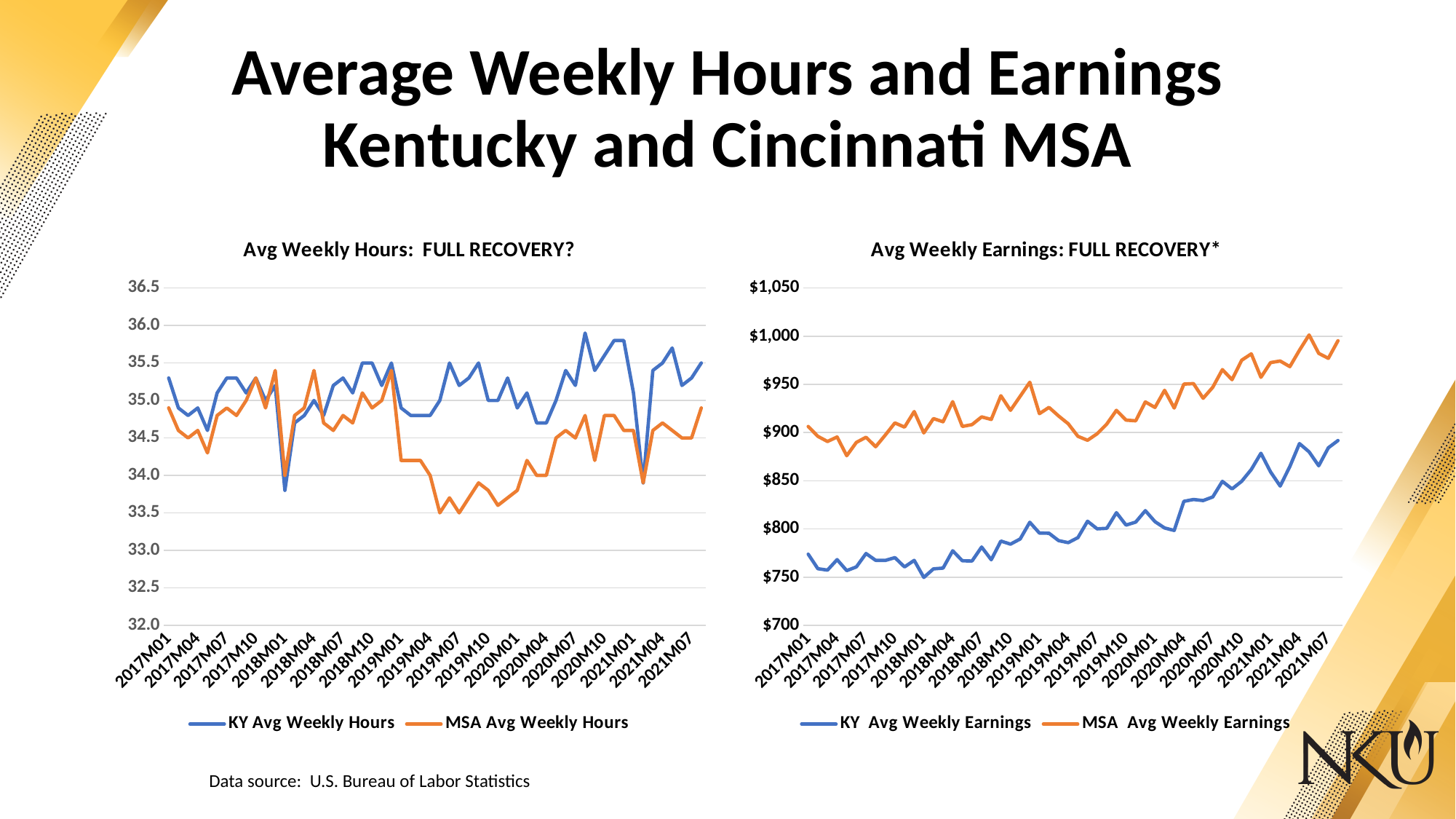
In the right chart, "Avg Weekly Earnings: FULL RECOVERY*", does MSA Avg Weekly Earnings generally rise or fall from 2019M07 to 2021M07? rise In the right chart, "Avg Weekly Earnings: FULL RECOVERY*", which series is higher at 2019M01, KY Avg Weekly Earnings or MSA Avg Weekly Earnings? MSA Avg Weekly Earnings In the right chart, "Avg Weekly Earnings: FULL RECOVERY*", is the value for MSA Avg Weekly Earnings at 2021M07 greater or less than $950? greater In the right chart, "Avg Weekly Earnings: FULL RECOVERY*", does KY Avg Weekly Earnings generally rise or fall from 2017M01 to 2021M07? rise In the left chart, "Avg Weekly Hours: FULL RECOVERY?", which series is shown in orange? MSA Avg Weekly Hours In the right chart, "Avg Weekly Earnings: FULL RECOVERY*", is the value for KY Avg Weekly Earnings at 2021M07 greater or less than $850? greater In the left chart, "Avg Weekly Hours: FULL RECOVERY?", is the value for MSA Avg Weekly Hours at 2019M07 greater or less than 34.0? less What kind of chart is the left chart titled "Avg Weekly Hours: FULL RECOVERY?"? line chart In the left chart, "Avg Weekly Hours: FULL RECOVERY?", which series is higher at 2019M07, KY Avg Weekly Hours or MSA Avg Weekly Hours? KY Avg Weekly Hours What is the title of the right chart? Avg Weekly Earnings: FULL RECOVERY* How many series does the legend of the right chart, "Avg Weekly Earnings: FULL RECOVERY*", list? 2